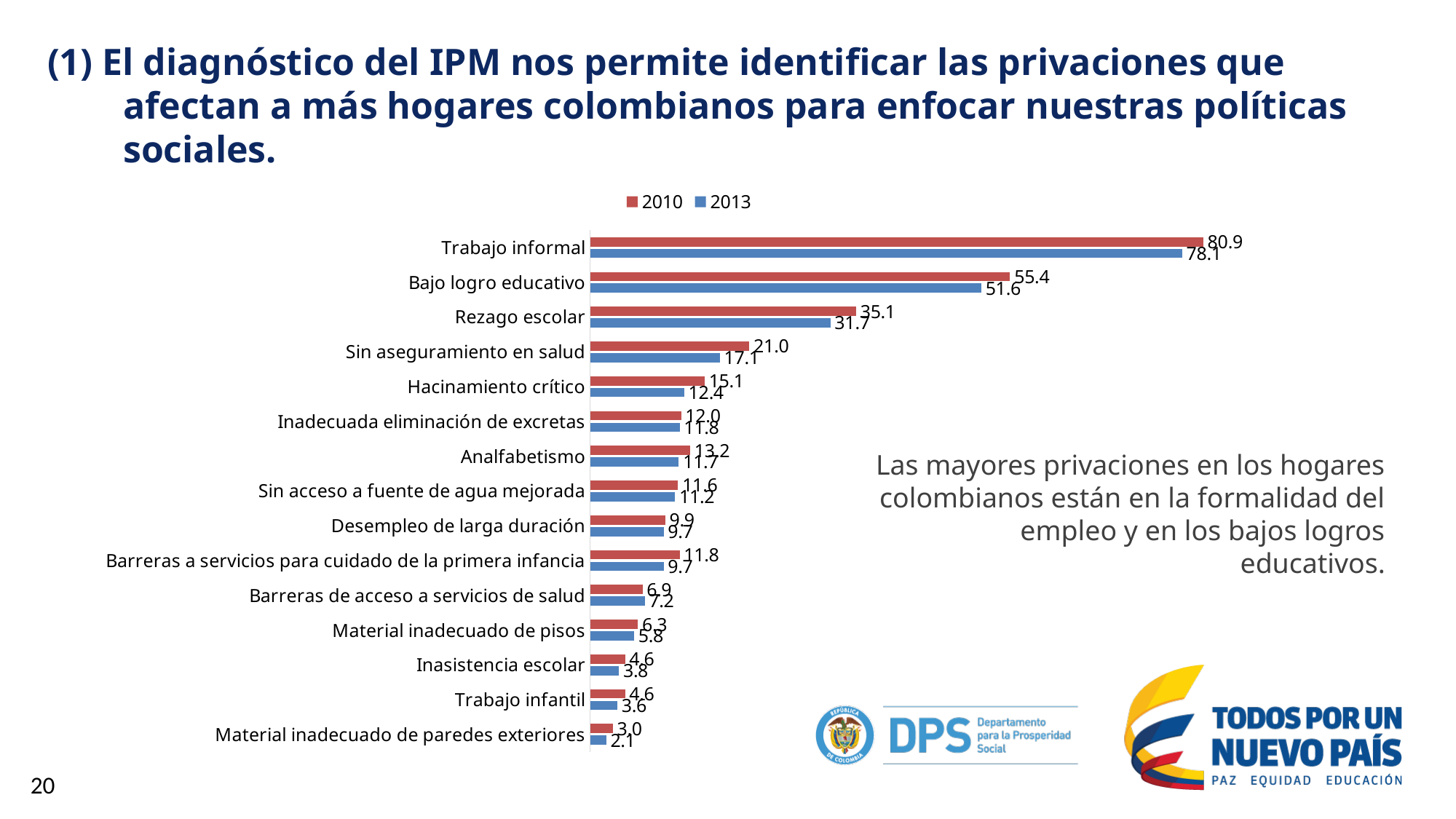
Which category has the highest 2013 value? Trabajo informal What kind of chart is shown on the slide? Bar chart For Barreras de acceso a servicios de salud, which year has the larger value, 2010 or 2013? 2013 What is the 2010 value for Hacinamiento crítico? 15.1 What is the difference between the 2010 and 2013 values for Trabajo informal? 2.8 What is the 2013 value for Sin aseguramiento en salud? 17.1 What is the 2013 value for Bajo logro educativo? 51.6 Which category has the lowest 2010 value? Material inadecuado de paredes exteriores What is the difference between the 2010 and 2013 values for Rezago escolar? 3.4 What is the 2010 value for Trabajo informal? 80.9 How many series does the legend list? 2 How many categories are shown in the chart? 15